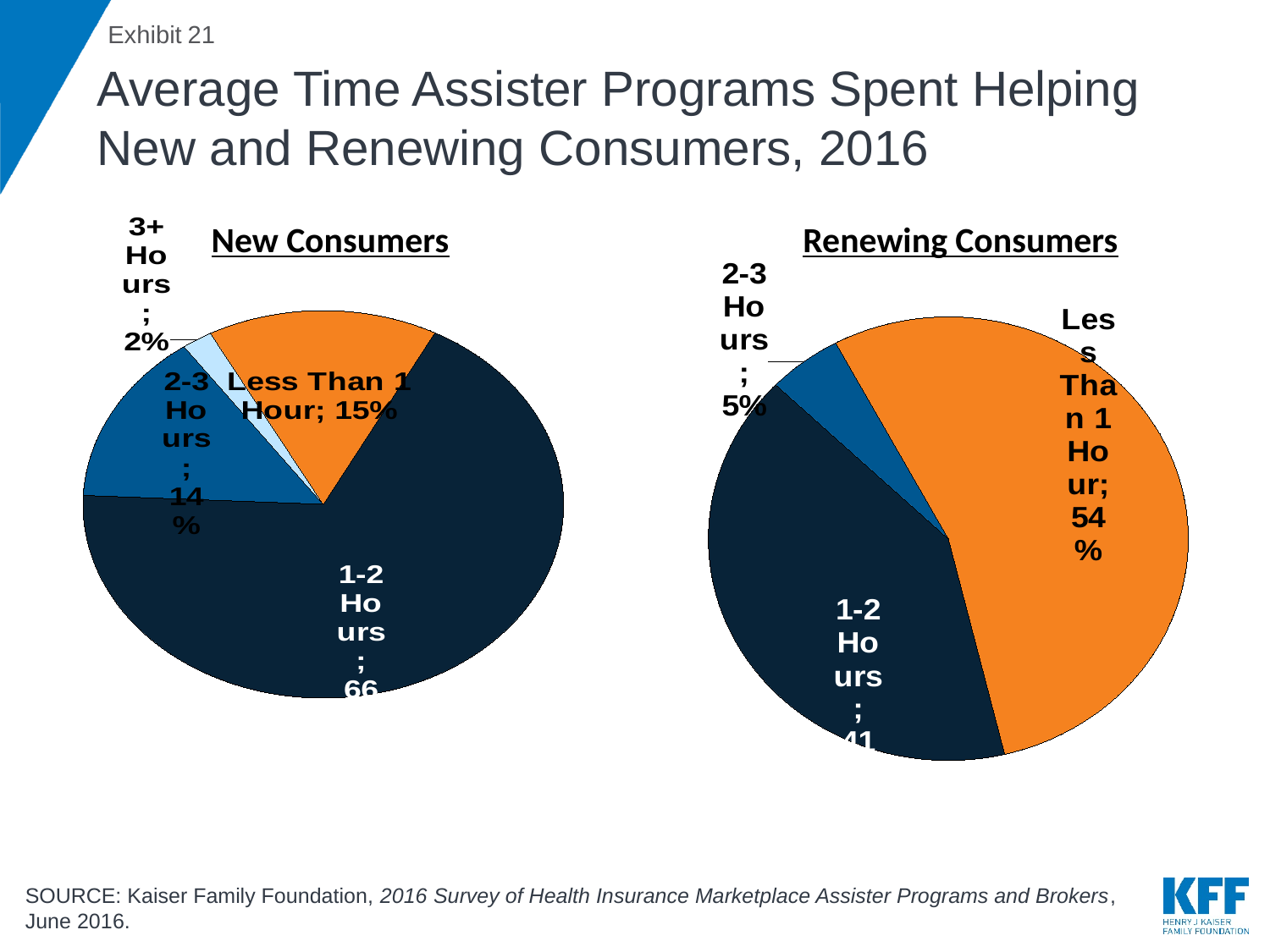
In the New Consumers pie chart, what is the value for 2-3 Hours? 14% In the New Consumers pie chart, what share of assister programs spent less than 1 hour helping consumers? 15% In the New Consumers pie chart, which category has the smallest slice? 3+ Hours What type of chart is used for the New Consumers and Renewing Consumers data? Pie chart Which chart shows a larger share for 2-3 Hours, New Consumers or Renewing Consumers? New Consumers How much larger is the Less Than 1 Hour share in the Renewing Consumers chart than in the New Consumers chart? 39 percentage points In the New Consumers pie chart, which category has the largest slice? 1-2 Hours In the New Consumers pie chart, what is the value for 3+ Hours? 2% In the Renewing Consumers pie chart, what is the value for 2-3 Hours? 5% In the Renewing Consumers pie chart, what is the value for Less Than 1 Hour? 54% In the Renewing Consumers pie chart, which category has the smallest slice? 2-3 Hours In the Renewing Consumers pie chart, which category has the largest slice? Less Than 1 Hour